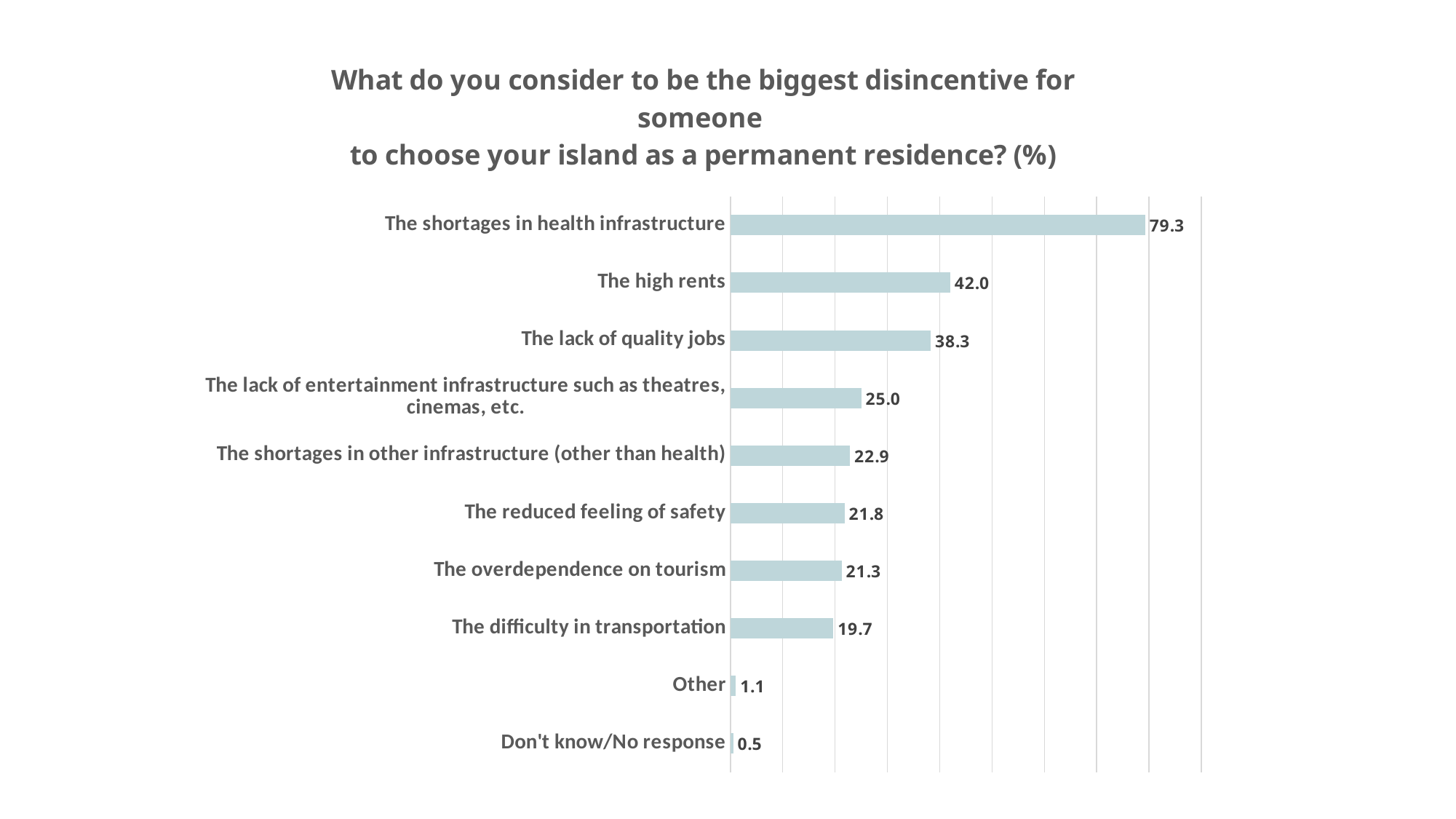
How many categories are shown in the chart? 10 Which category has the lowest value? Don't know/No response What is the value for 'Don't know/No response'? 0.5 What kind of chart is shown on the slide? Bar chart What is the difference between the values for 'The high rents' and 'The lack of quality jobs'? 3.7 Which is larger, the value for 'The lack of entertainment infrastructure such as theatres, cinemas, etc.' or the value for 'The shortages in other infrastructure (other than health)'? The lack of entertainment infrastructure such as theatres, cinemas, etc. What is the value for 'Other'? 1.1 Which category has the highest value? The shortages in health infrastructure What is the difference between the values for 'The shortages in health infrastructure' and 'The high rents'? 37.3 What is the value for 'The difficulty in transportation'? 19.7 What is the value for 'The high rents'? 42.0 What is the value for 'The shortages in health infrastructure'? 79.3